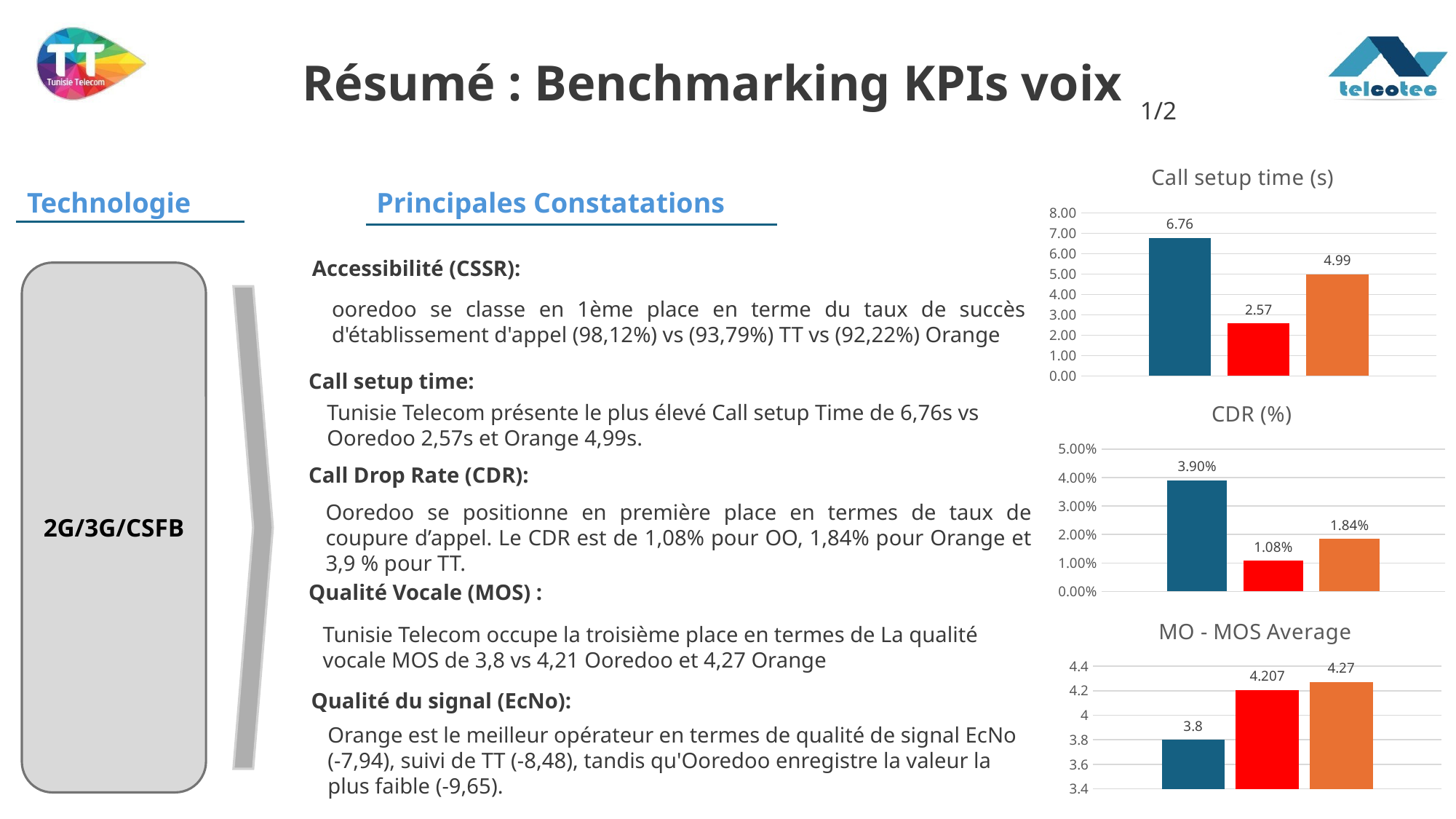
In the 'CDR (%)' chart, which bar is the highest? The blue (left) bar In the 'Call setup time (s)' chart, what is the value shown on the first (blue) bar? 6.76 In the 'Call setup time (s)' chart, what is the difference between the highest and lowest bar values? 4.19 What type of chart is the 'MO - MOS Average' chart? Bar chart In the 'MO - MOS Average' chart, what is the value shown on the red (middle) bar? 4.207 In the 'CDR (%)' chart, is the value of the blue bar greater or less than 3.00%? greater In the 'Call setup time (s)' chart, what is the value shown on the red bar? 2.57 In the 'CDR (%)' chart, what is the value shown on the orange (right) bar? 1.84% How many bars are plotted in the 'CDR (%)' chart? 3 In the 'Call setup time (s)' chart, which bar is the lowest? The red (middle) bar In the 'MO - MOS Average' chart, is the orange bar or the blue bar larger? The orange bar In the 'MO - MOS Average' chart, which bar is the lowest? The blue (left) bar